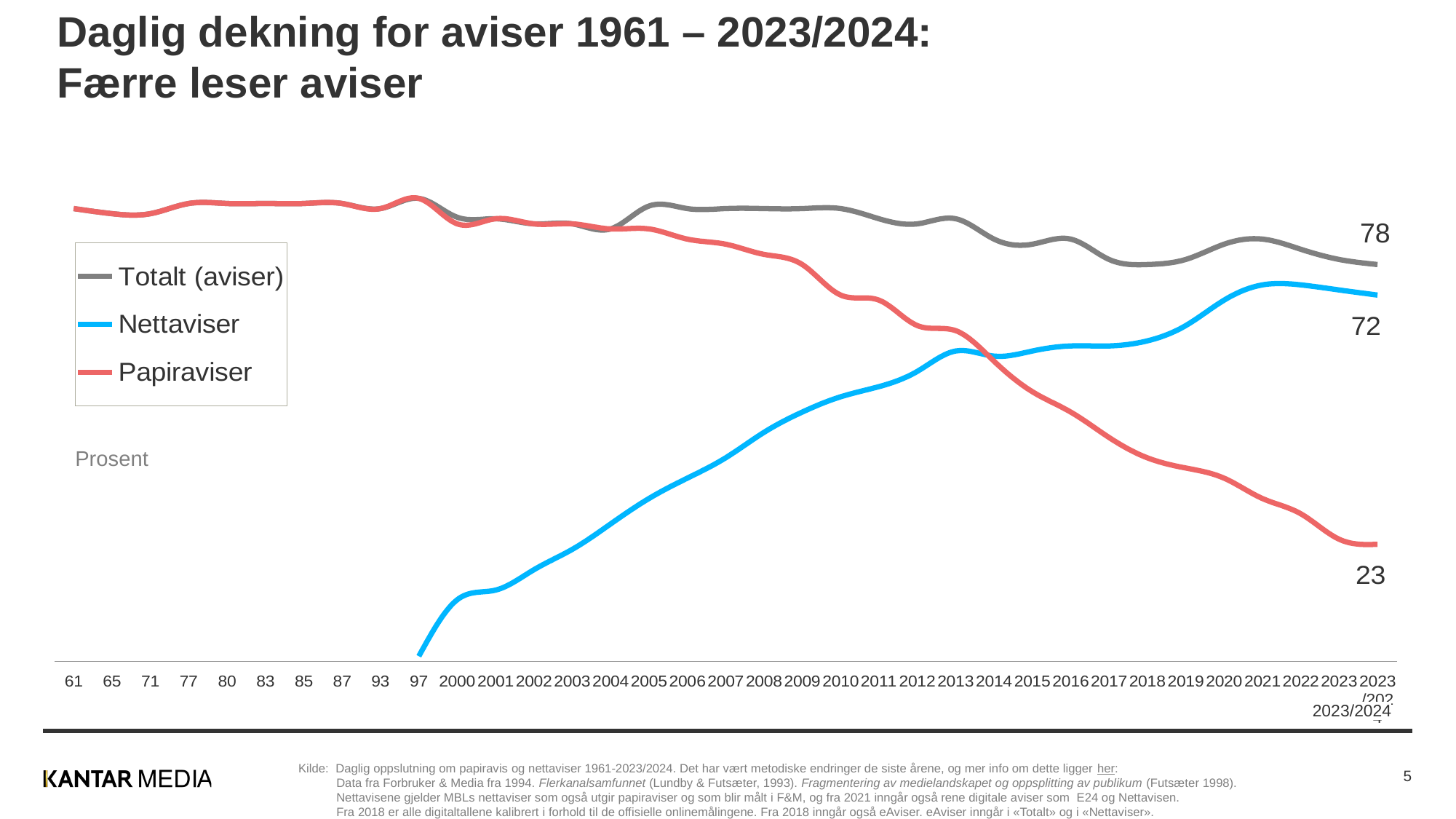
What is the value for Totalt (aviser) in 2023/2024? 78 Which series has the highest value in 2023/2024? Totalt (aviser) Does the Papiraviser line rise or fall from 2013 to 2023/2024? Fall What kind of chart is shown on the slide? Line chart Does the Nettaviser line rise or fall from 97 to 2013? Rise Which series has the lowest value in 2023/2024? Papiraviser What is the value for Nettaviser in 2023/2024? 72 What is the difference between Totalt (aviser) and Nettaviser in 2023/2024? 6 How many series does the legend list? 3 What is the difference between Nettaviser and Papiraviser in 2023/2024? 49 What is the value for Papiraviser in 2023/2024? 23 In 2023/2024, which is larger: Nettaviser or Papiraviser? Nettaviser